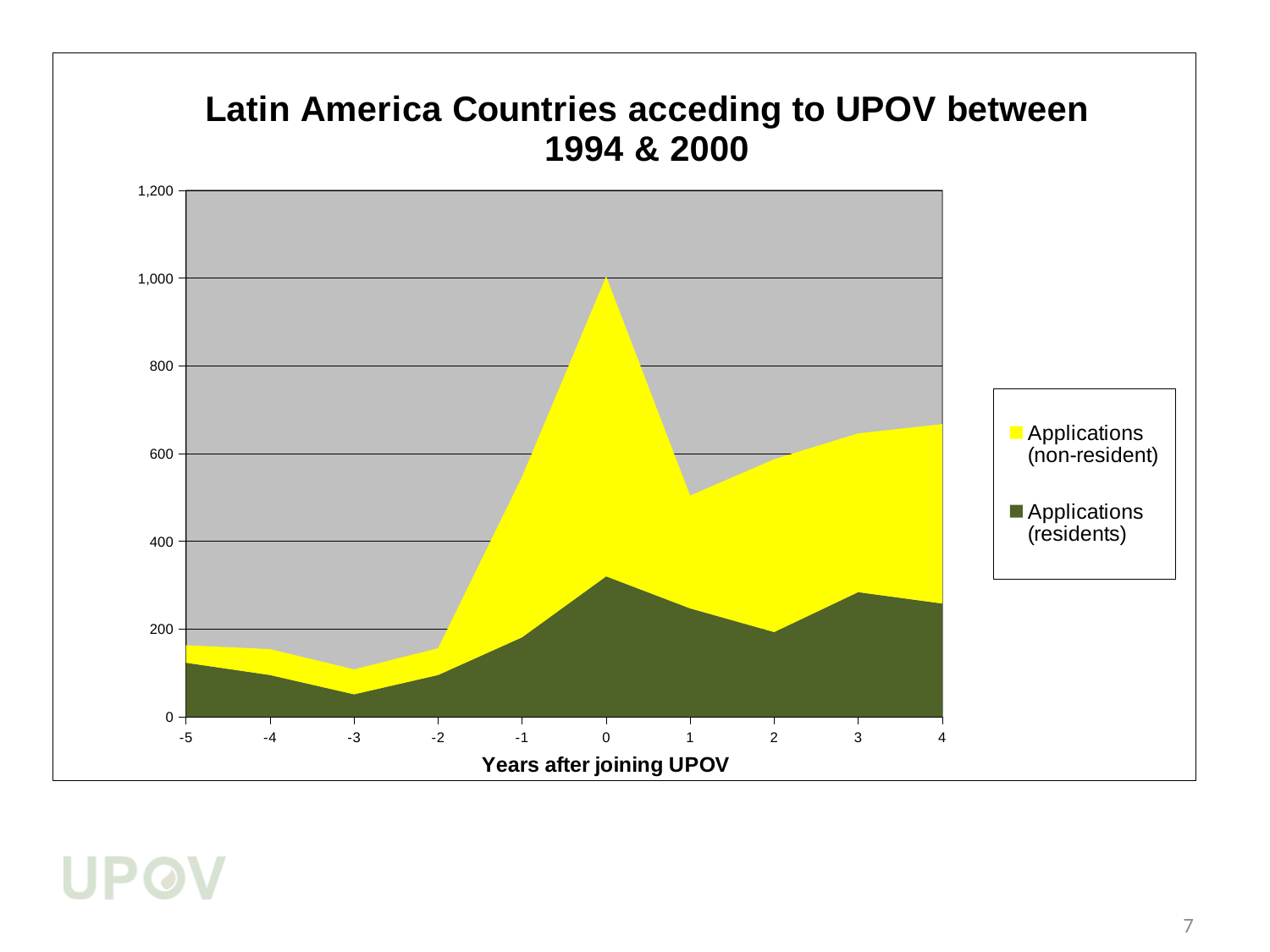
Is the value for Applications (residents) at year 0 greater or less than 200? greater At which year after joining UPOV is the total number of applications lowest? -3 At which year after joining UPOV is the total number of applications highest? 0 How many points are plotted along the x axis? 10 Is the total number of applications at year 4 greater or less than 600? greater Do total applications rise or fall between year -3 and year 0? rise Is the total number of applications at year 0 greater or less than 800? greater What kind of chart is shown on the slide? Stacked area chart How many series does the legend list? 2 Which series is shown in yellow? Applications (non-resident) What is the title of the x axis? Years after joining UPOV